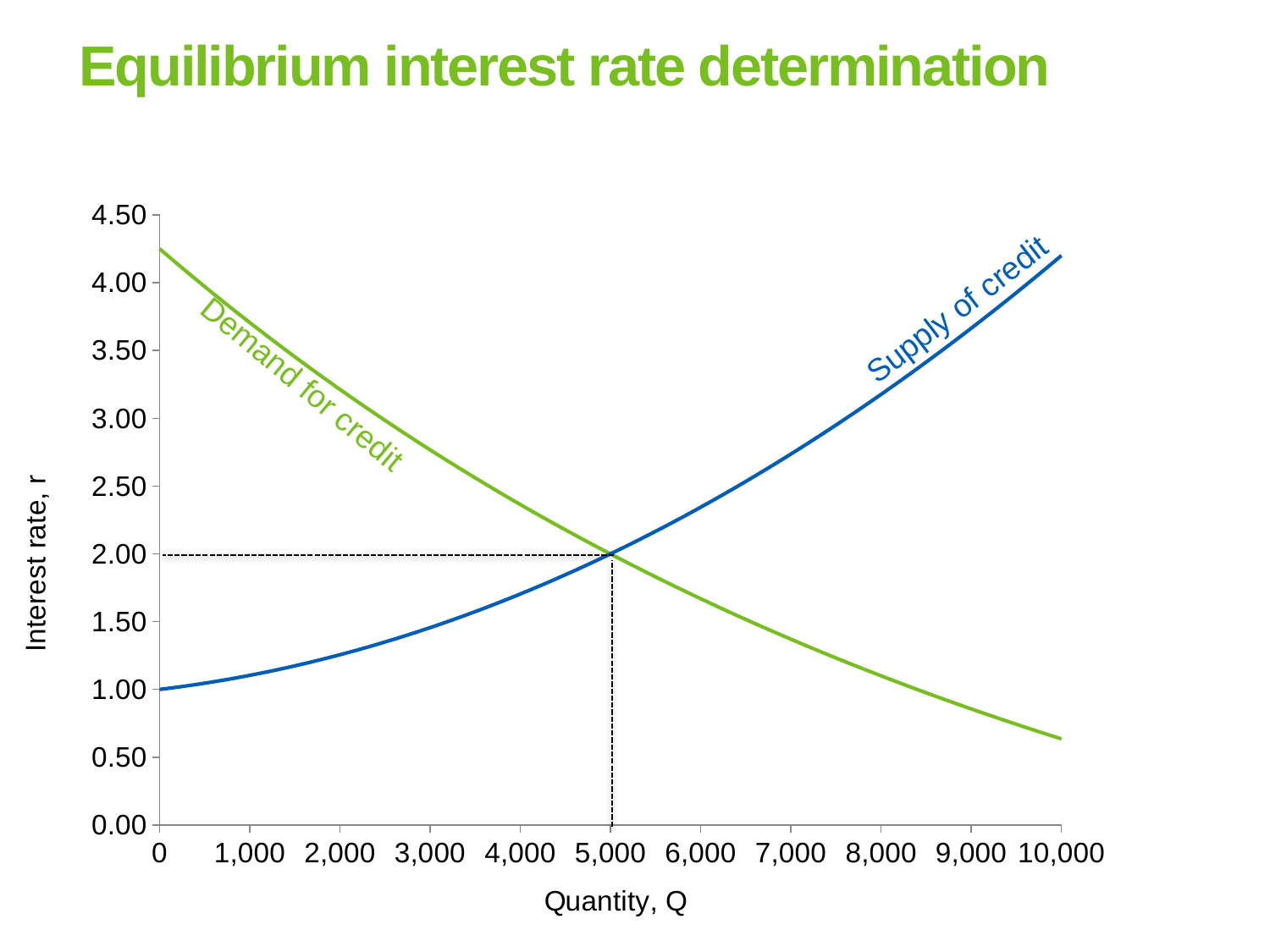
At what quantity do the Demand for credit and Supply of credit curves intersect, as marked by the dashed line? 5,000 At a quantity of 2,000, which curve shows the higher interest rate, Demand for credit or Supply of credit? Demand for credit How many curves (series) are plotted on the chart? 2 Does the Demand for credit curve rise or fall as quantity increases? fall At what interest rate do the Demand for credit and Supply of credit curves intersect, as marked by the dashed line? 2.00 What kind of chart is shown on the slide? line chart What is the label of the vertical axis of the chart? Interest rate, r What is the interest rate on the Supply of credit curve at a quantity of 0? 1.00 Does the Supply of credit curve rise or fall as quantity increases? rise Is the interest rate on the Demand for credit curve at a quantity of 0 greater or less than 4.00? greater At a quantity of 8,000, which curve shows the higher interest rate, Demand for credit or Supply of credit? Supply of credit Is the interest rate on the Demand for credit curve at a quantity of 10,000 greater or less than 1.00? less